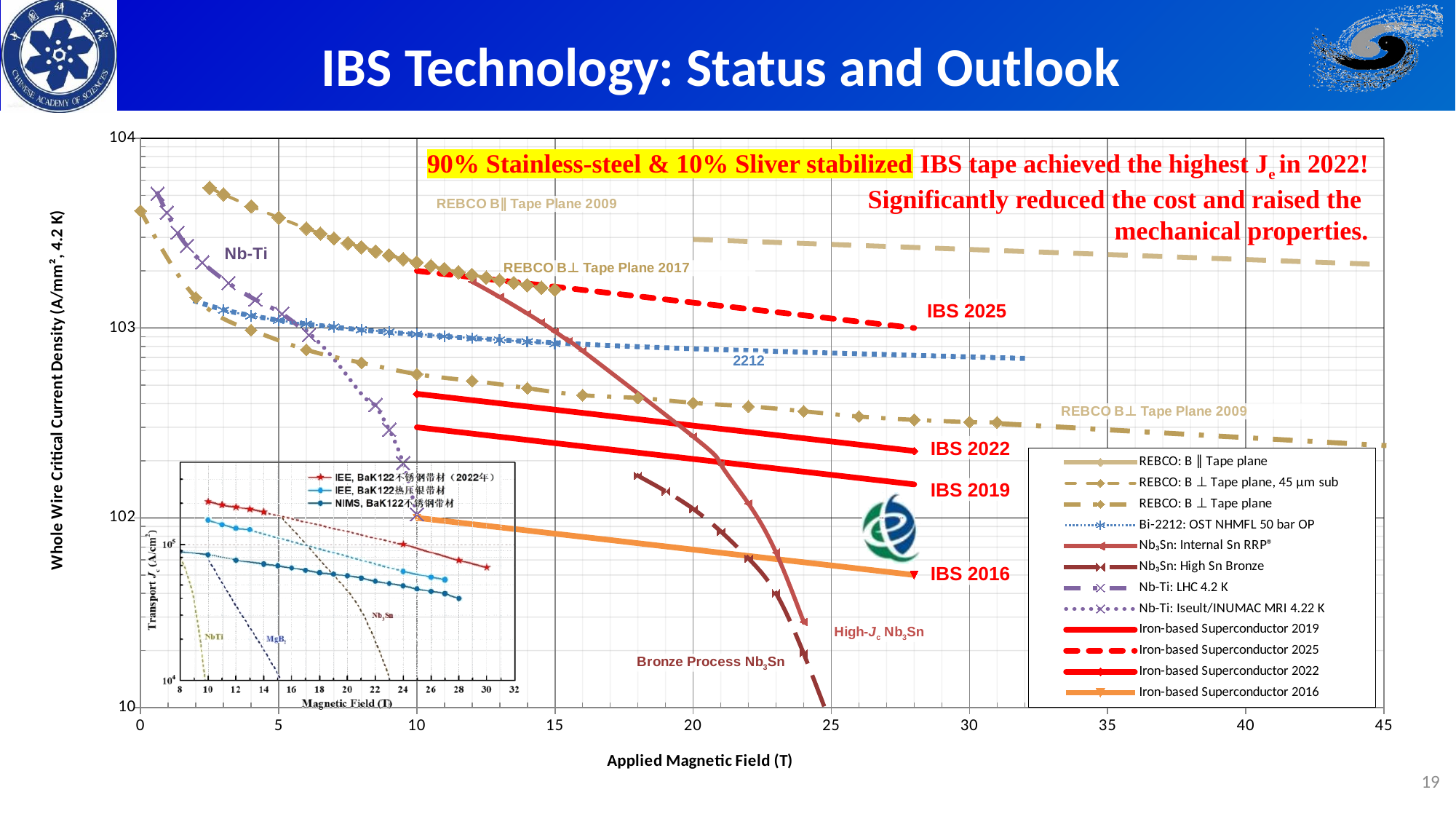
In the main chart, which of the four IBS curves is the lowest? IBS 2016 In the inset chart, which series has the highest transport Jc values? IEE, BaK122不锈钢带材（2022年） In the main chart, do the critical current density curves rise or fall as the applied magnetic field increases? Fall What is the x-axis label of the main chart? Applied Magnetic Field (T) In the main chart, which series is drawn as the orange line? Iron-based Superconductor 2016 In the main chart, which of the four IBS curves is the highest? IBS 2025 In the inset chart, how many series does the legend list? 3 What kind of chart is the main chart on the slide? Line chart In the main chart, how many Iron-based Superconductor curves (IBS years) are plotted? 4 In the main chart, how many series does the legend list? 12 In the main chart, which is higher at 28 T: the IBS 2022 curve or the IBS 2019 curve? IBS 2022